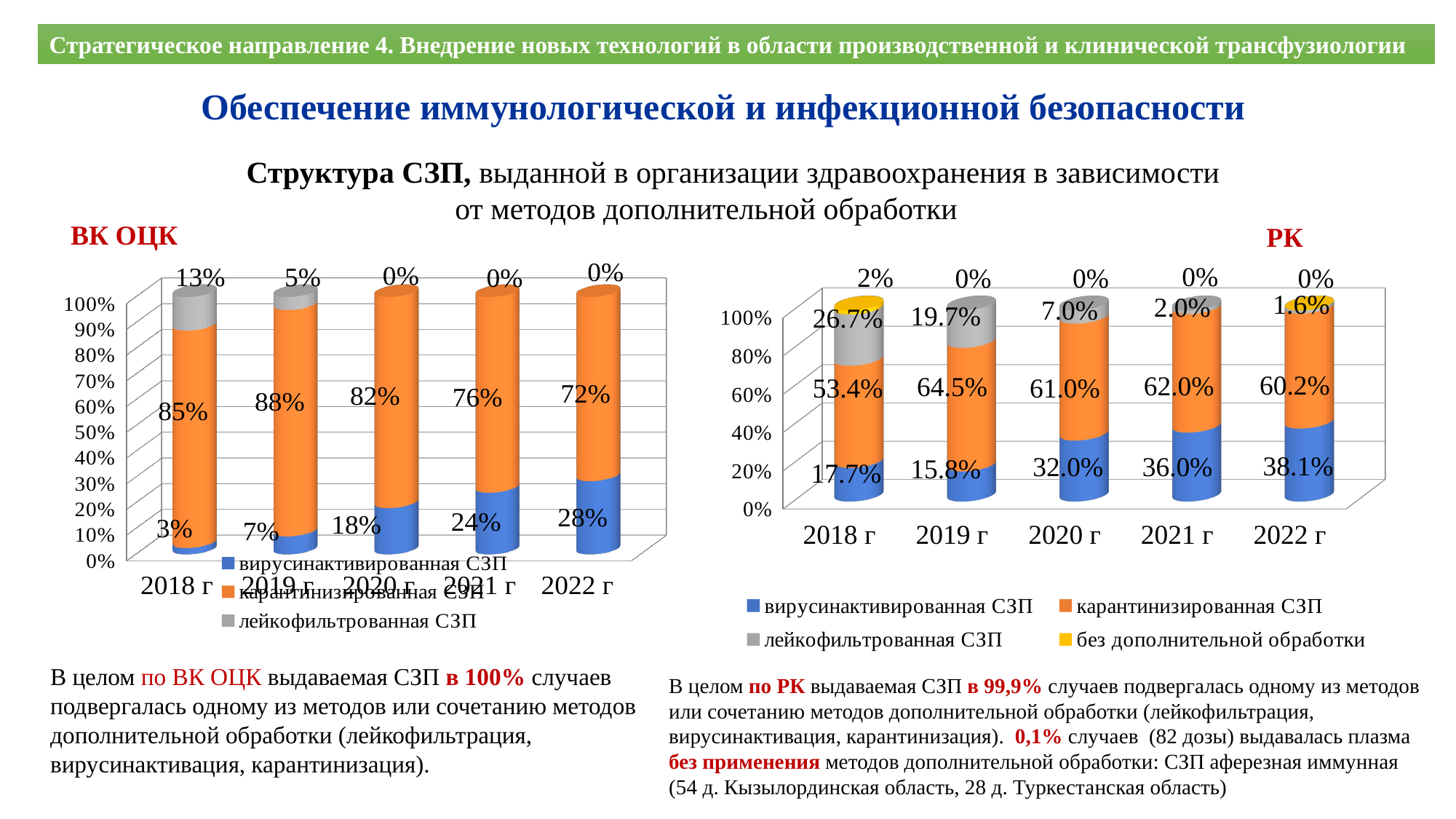
How many series does the legend of the РК chart list? 4 In the ВК ОЦК chart, which year has the highest share of вирусинактивированная СЗП? 2022 г What kind of chart is the ВК ОЦК chart on the left? stacked bar chart In the ВК ОЦК chart, does the share of вирусинактивированная СЗП rise or fall from 2018 г to 2022 г? rise In the РК chart, what is the value for карантинизированная СЗП in 2019 г? 64.5% In the ВК ОЦК chart, what is the value for вирусинактивированная СЗП in 2022 г? 28% In the РК chart, which is larger: the лейкофильтрованная СЗП share in 2018 г or in 2020 г? 2018 г In the РК chart, what is the value for вирусинактивированная СЗП in 2020 г? 32.0% In the ВК ОЦК chart, what is the value for карантинизированная СЗП in 2019 г? 88% In the ВК ОЦК chart, what is the value for лейкофильтрованная СЗП in 2018 г? 13% In the РК chart, which year has the lowest share of вирусинактивированная СЗП? 2019 г In the ВК ОЦК chart, what is the difference between the карантинизированная СЗП values for 2019 г and 2022 г? 16%